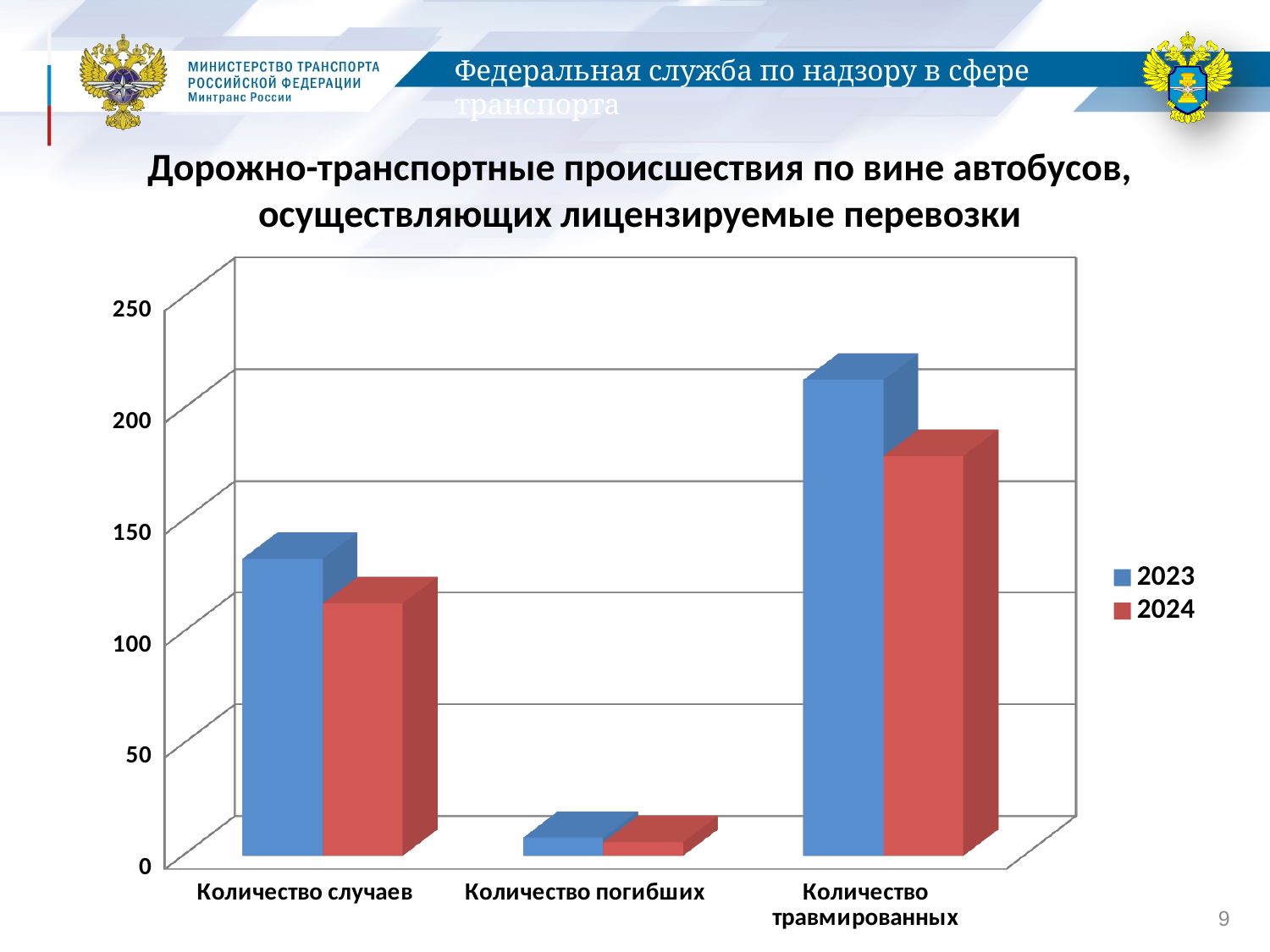
Is the 2023 value for Количество случаев greater or less than 100? greater Is the 2024 value for Количество травмированных greater or less than 200? less Which colour represents the 2024 series in the legend? red How many categories are shown on the x axis? 3 Is the 2023 value for Количество погибших greater or less than 50? less For Количество травмированных, which year has the larger value, 2023 or 2024? 2023 Which category has the lowest values in the chart? Количество погибших For Количество случаев, which year has the larger value, 2023 or 2024? 2023 What kind of chart is shown on the slide? bar chart How many series does the legend list? 2 Which category has the highest values in the chart? Количество травмированных